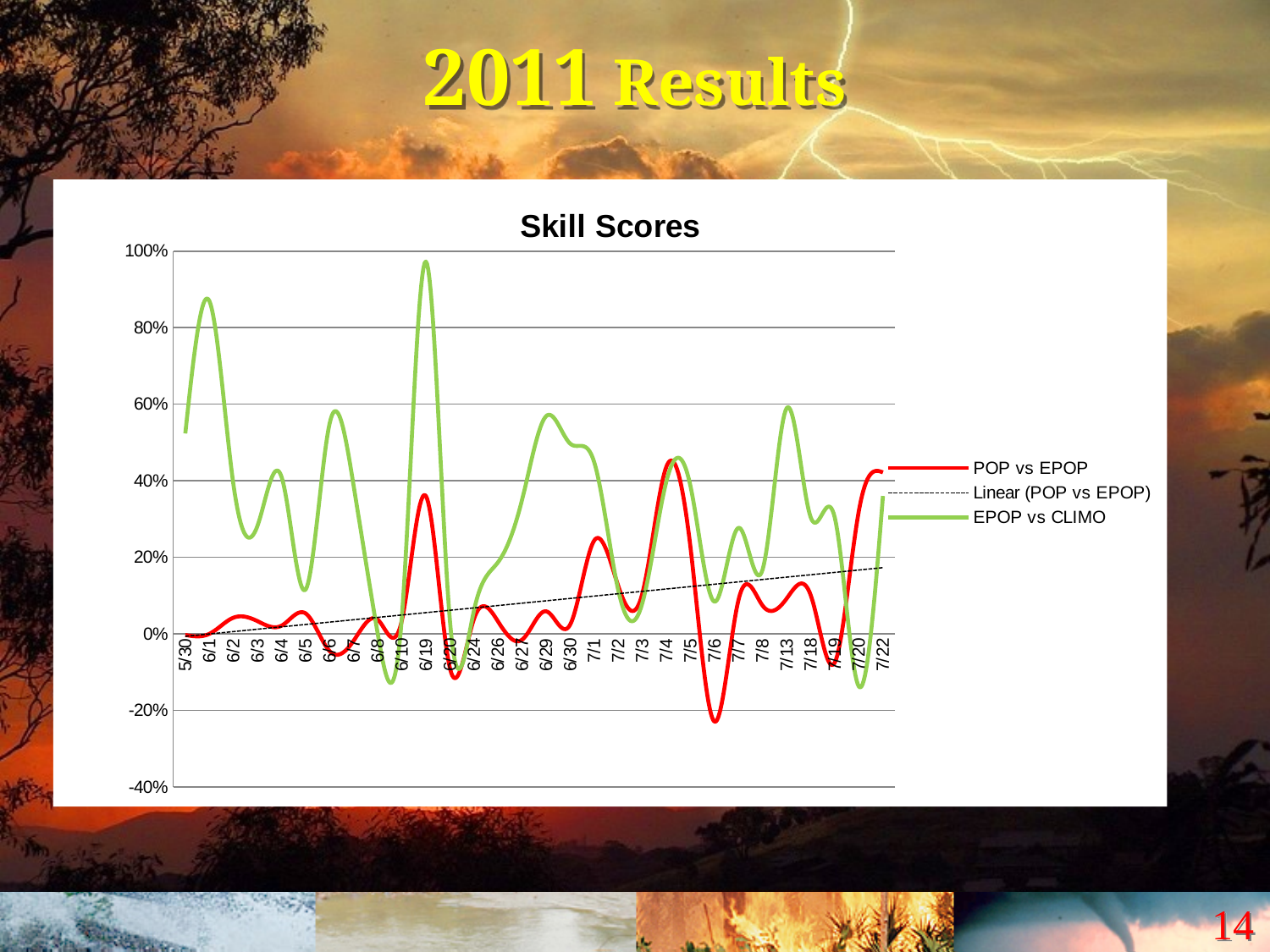
What kind of chart is shown on the slide? line chart What is the title of the chart on the slide? Skill Scores On which date does the EPOP vs CLIMO series reach its highest value? 6/19 How many series does the legend of the Skill Scores chart list? 3 Is the EPOP vs CLIMO value on 7/13 greater or less than 40%? greater Is the EPOP vs CLIMO value on 6/19 greater or less than 80%? greater On which date does the POP vs EPOP series reach its lowest value? 7/6 What colour is the EPOP vs CLIMO line in the Skill Scores chart? green Is the POP vs EPOP value on 7/6 greater or less than 0%? less On 6/1, which series has the larger value, POP vs EPOP or EPOP vs CLIMO? EPOP vs CLIMO Does the Linear (POP vs EPOP) trend line rise or fall from left to right across the x axis? rise